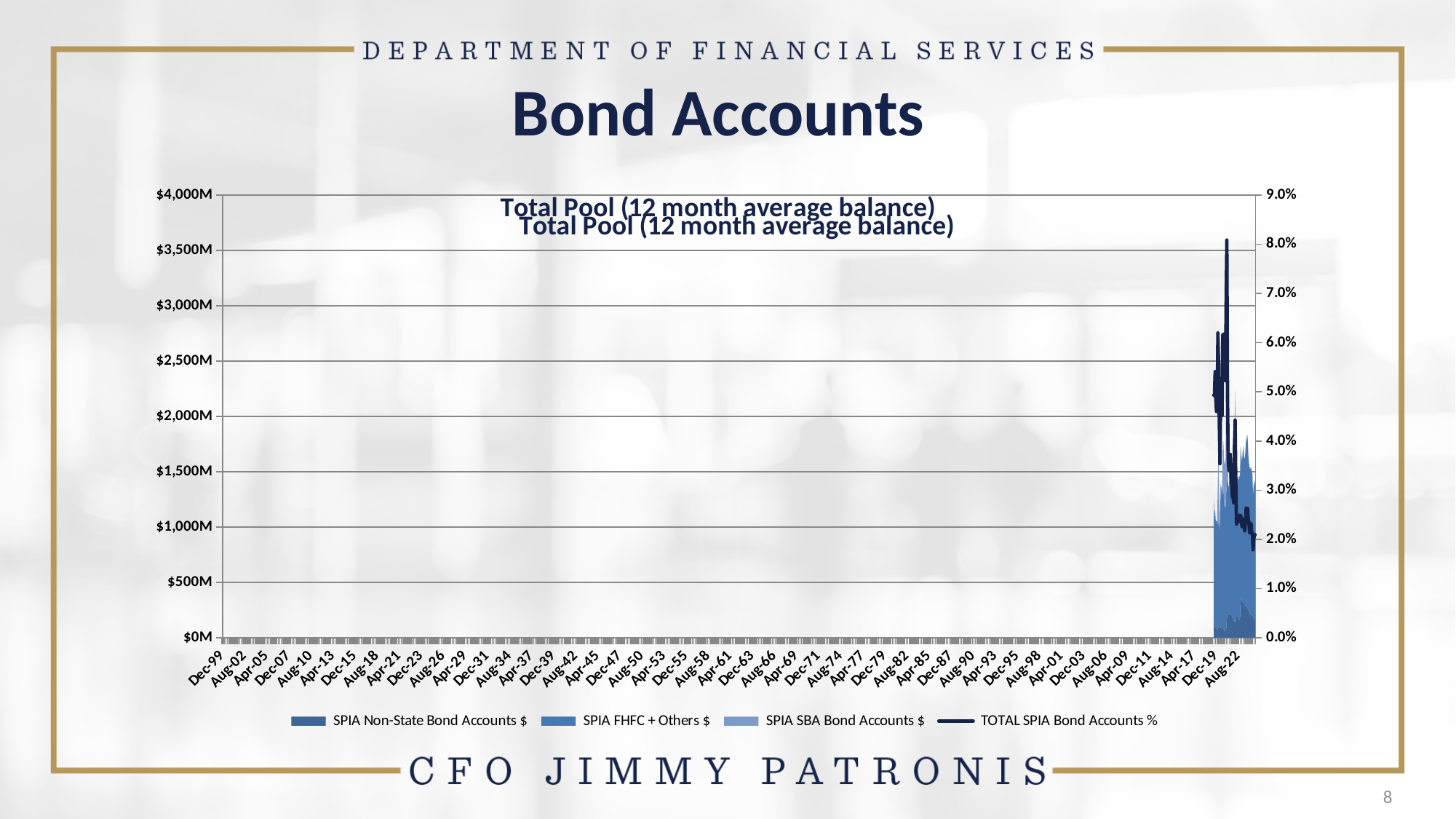
How many series does the legend list on the Total Pool (12 month average balance) chart? 4 Is the peak value of the TOTAL SPIA Bond Accounts % line greater or less than 9.0%? less Is the highest point of the stacked dollar balances greater or less than $3,000M? less Is the peak value of the TOTAL SPIA Bond Accounts % line greater or less than 7.0%? greater Which series in the legend is plotted as a line rather than a filled area? TOTAL SPIA Bond Accounts % What is the title of the chart on the slide? Total Pool (12 month average balance)